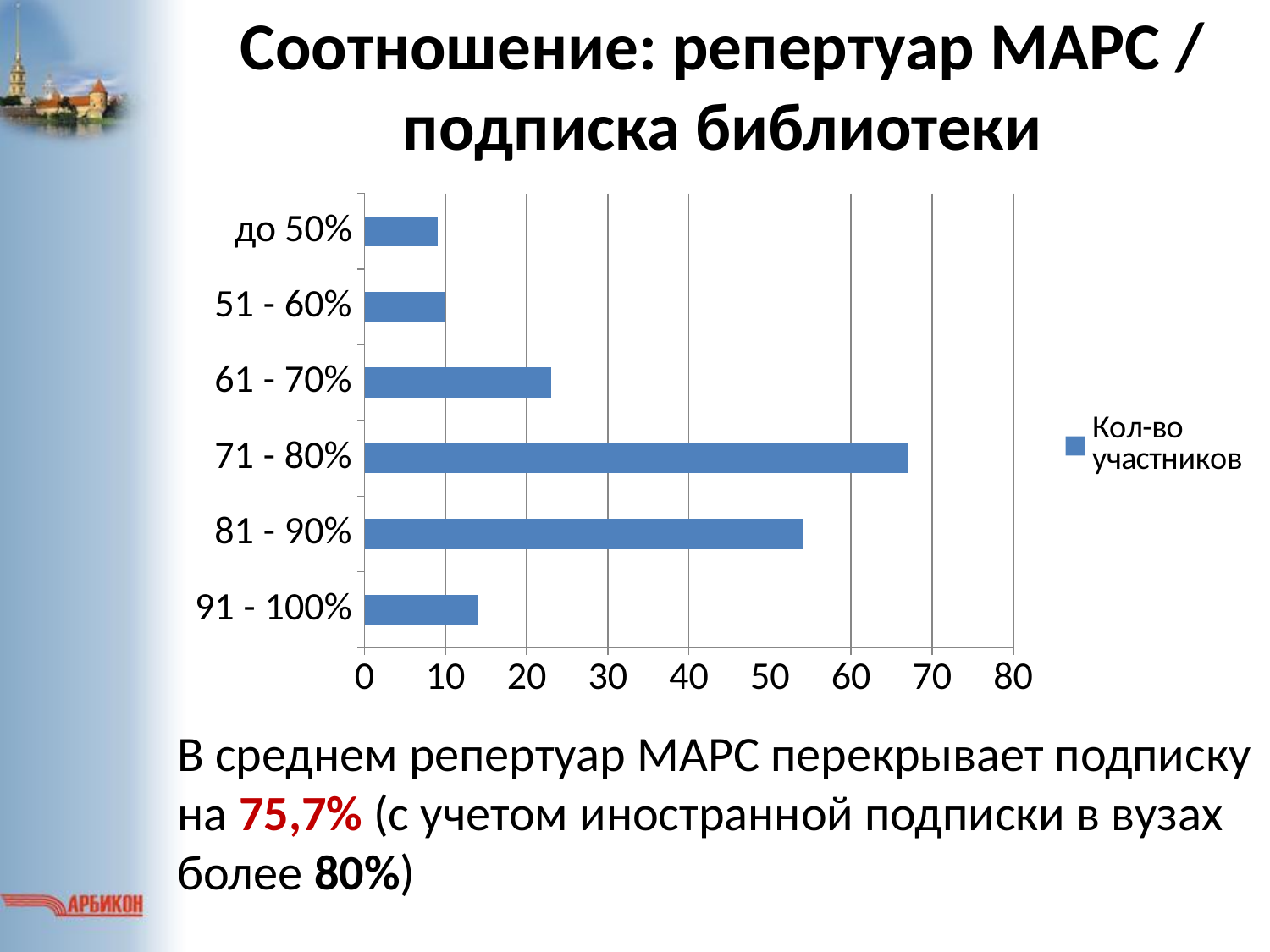
Is the value for 61 - 70% greater or less than 20? greater What is the title of the slide containing the chart? Соотношение: репертуар МАРС / подписка библиотеки Which is larger, the value for 61 - 70% or the value for 91 - 100%? 61 - 70% Is the value for 81 - 90% greater or less than 50? greater What is the legend entry for the series on the chart? Кол-во участников Which is larger, the value for 71 - 80% or the value for 81 - 90%? 71 - 80% How many categories are shown on the chart? 6 Is the value for 71 - 80% greater or less than 60? greater How many series does the legend list? 1 Which category has the highest value? 71 - 80% What kind of chart is shown on the slide? bar chart